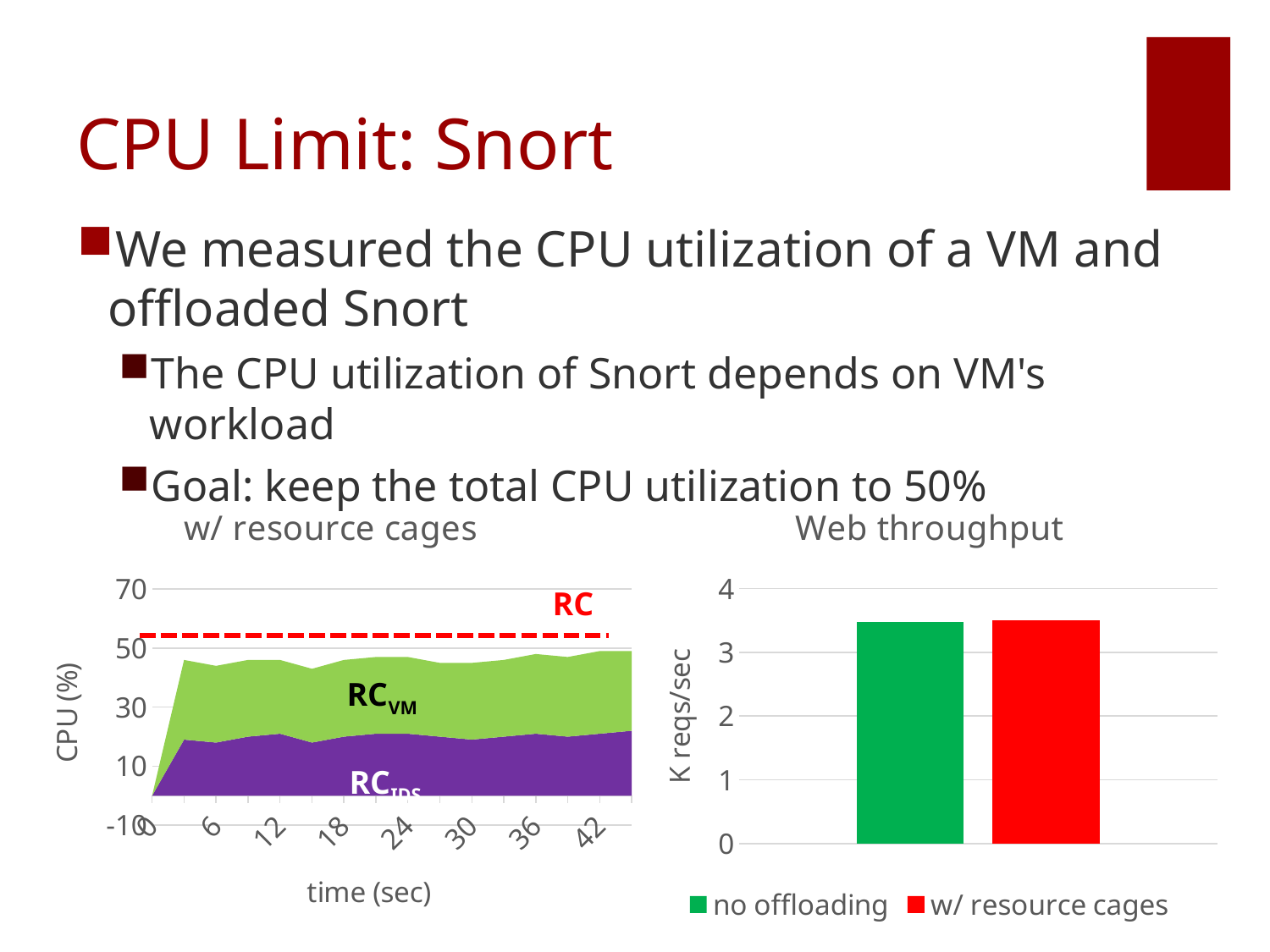
In the w/ resource cages chart on the left, is the total CPU utilization at time 24 greater or less than 70? less What kind of chart is the Web throughput chart on the right? bar chart In the w/ resource cages chart on the left, is the RC_IDS value at time 24 greater or less than 30? less What are the two legend entries of the Web throughput chart? no offloading, w/ resource cages How many bars are plotted in the Web throughput chart? 2 How many series does the legend of the Web throughput chart list? 2 In the w/ resource cages chart on the left, is the RC_IDS value at time 12 greater or less than 10? greater In the w/ resource cages chart on the left, which series occupies the larger area at time 24, RC_VM or RC_IDS? RC_VM What is the y-axis label of the Web throughput chart? K reqs/sec